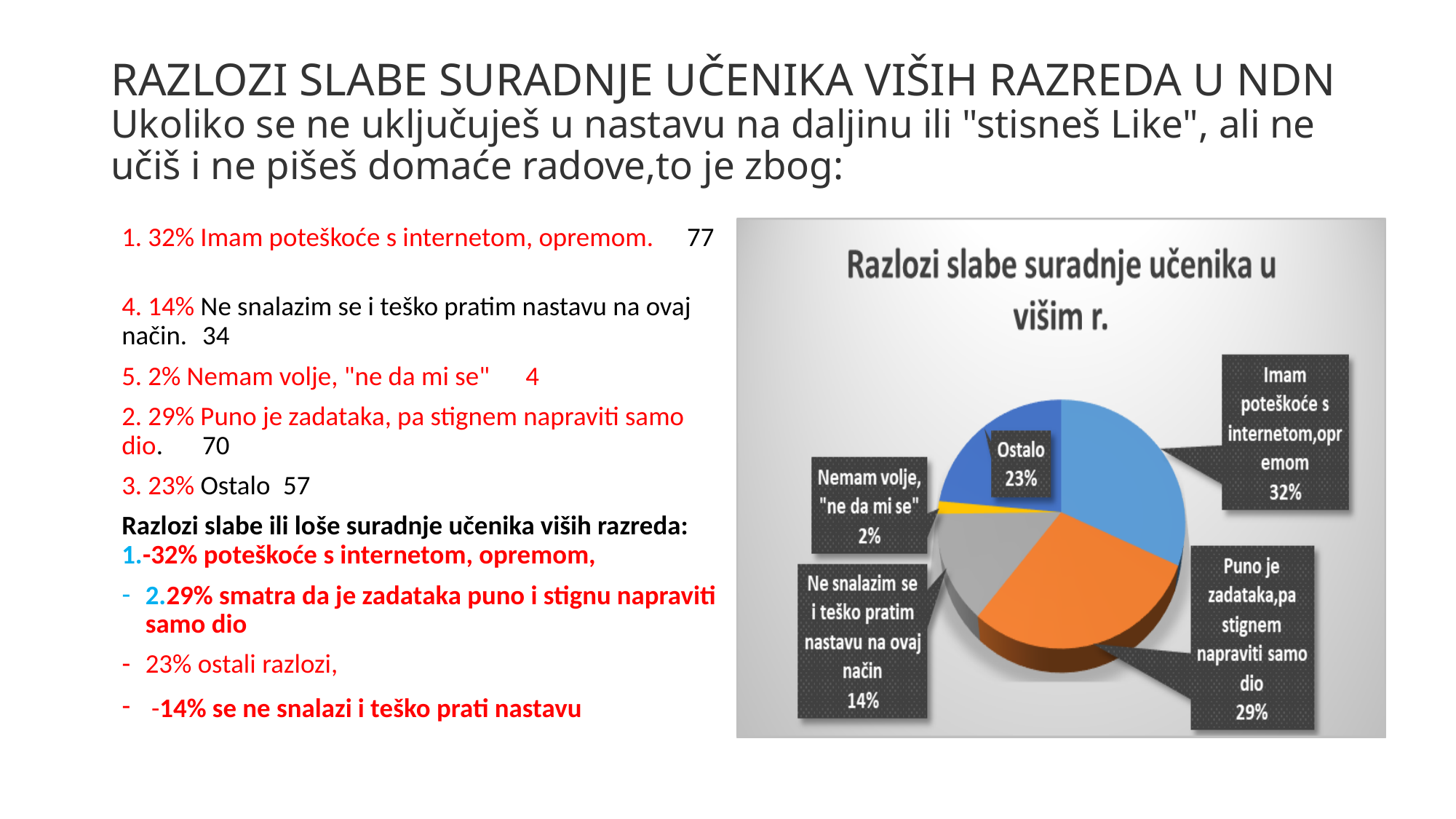
What percentage of the pie is labelled "Puno je zadataka,pa stignem napraviti samo dio"? 29% Which slice of the pie chart is the smallest? Nemam volje, "ne da mi se" What percentage of the pie is labelled "Ostalo"? 23% How many slices does the pie chart have? 5 What percentage of the pie is labelled "Nemam volje, "ne da mi se""? 2% What percentage of the pie is labelled "Imam poteškoće s internetom,opremom"? 32% What kind of chart is shown on the slide? pie chart What is the difference in percentage points between the "Ostalo" slice and the "Ne snalazim se i teško pratim nastavu na ovaj način" slice? 9 What is the title of the chart? Razlozi slabe suradnje učenika u višim r. Which slice of the pie chart is the largest? Imam poteškoće s internetom,opremom What percentage of the pie is labelled "Ne snalazim se i teško pratim nastavu na ovaj način"? 14% Which slice is larger: "Puno je zadataka,pa stignem napraviti samo dio" or "Ostalo"? Puno je zadataka,pa stignem napraviti samo dio